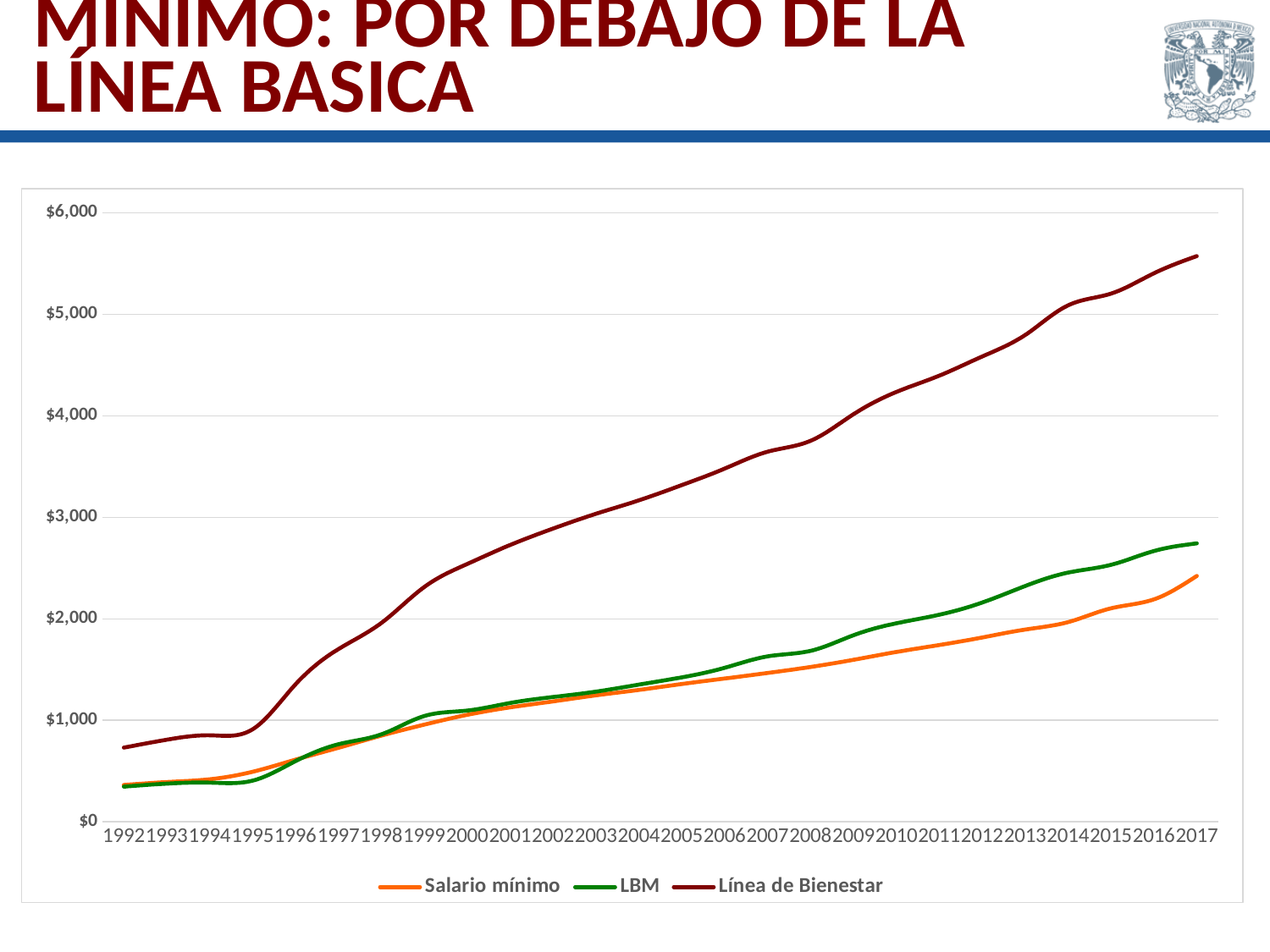
What colour is the Salario mínimo line in the legend? orange In 2017, which is larger: LBM or Salario mínimo? LBM How many series does the legend list? 3 How many years are plotted along the x axis? 26 Is the value of LBM in 2017 greater or less than $2,000? greater Which series has the highest value in 2017? Línea de Bienestar What kind of chart is shown on the slide? line chart Which series has the lowest value in 2017? Salario mínimo Is the value of Salario mínimo in 1992 greater or less than $1,000? less Is the value of Línea de Bienestar in 2017 greater or less than $5,000? greater Does the Línea de Bienestar series rise or fall from 1992 to 2017? rise